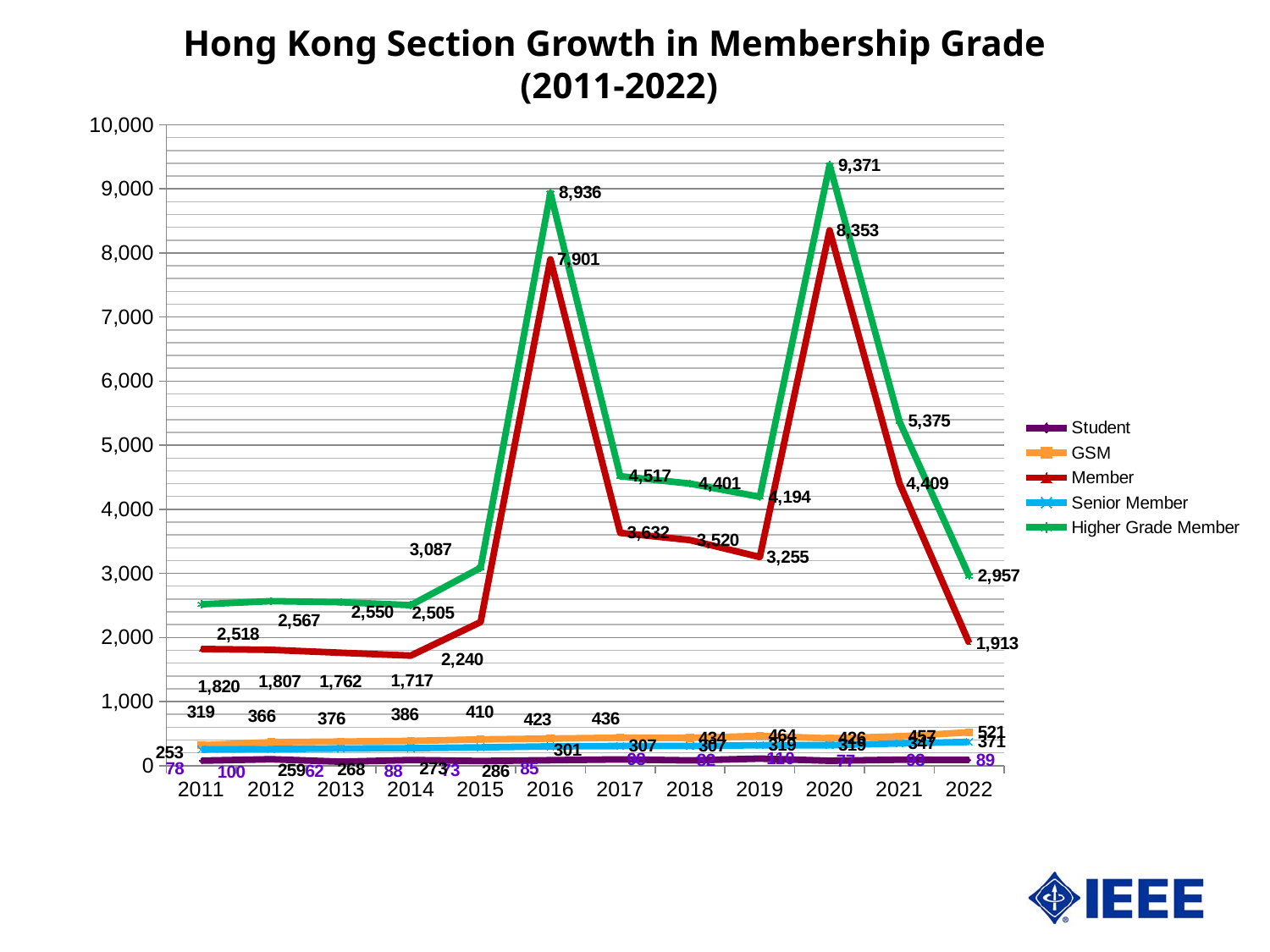
What is the Senior Member value for 2011? 253 How many series does the legend list? 5 What is the GSM value for 2022? 521 In which year is the Higher Grade Member value highest? 2020 What type of chart is shown on the slide? Line chart What is the Higher Grade Member value for 2020? 9,371 In which year is the Member value lowest? 2014 What is the difference between the Higher Grade Member values for 2020 and 2016? 435 Is the Higher Grade Member value for 2021 greater or less than 5,000? greater How many years are plotted along the x axis? 12 What is the Member value for 2016? 7,901 Which year has the larger Member value, 2016 or 2020? 2020